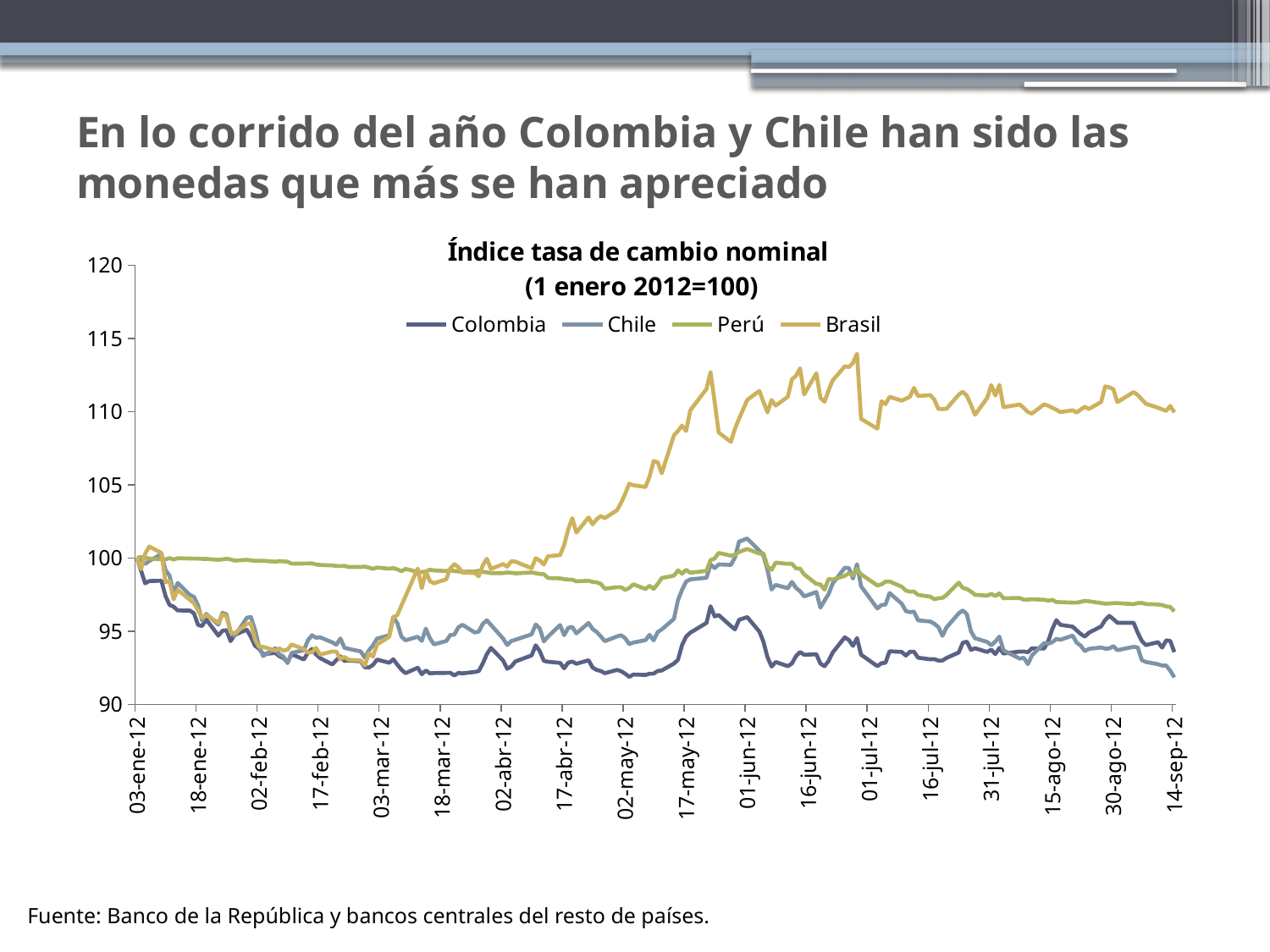
At 14-sep-12, which is larger, the value for Brasil or the value for Perú? Brasil What kind of chart is shown on the slide? line chart Is the value for Colombia at 14-sep-12 greater or less than 95? less Is the value for Brasil at 14-sep-12 greater or less than 105? greater Which series are listed in the legend? Colombia, Chile, Perú, Brasil How many series does the legend list? 4 Is the value for Perú at 14-sep-12 greater or less than 100? less Which series has the highest value at 14-sep-12? Brasil Which series has the lowest value at 14-sep-12? Chile Does the Perú series rise or fall between 03-ene-12 and 14-sep-12? fall Does the Brasil series rise or fall between 03-ene-12 and 14-sep-12? rise What is the title of the chart? Índice tasa de cambio nominal (1 enero 2012=100)